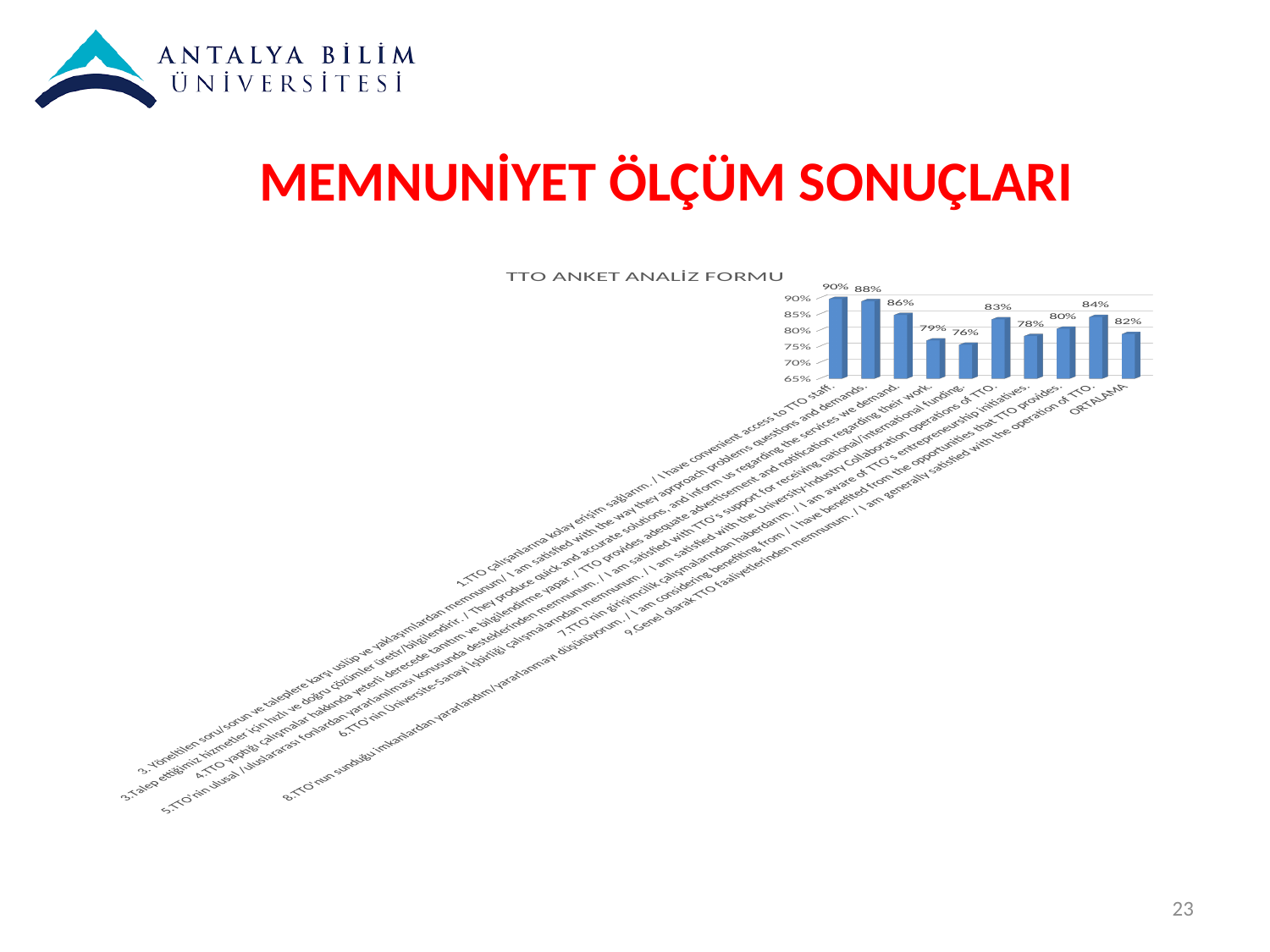
What is the highest value shown in the TTO ANKET ANALİZ FORMU chart? 90% How many bars are plotted in the TTO ANKET ANALİZ FORMU chart? 10 What is the value of the ORTALAMA bar in the TTO ANKET ANALİZ FORMU chart? 82% What is the title of the chart on the slide? TTO ANKET ANALİZ FORMU What is the difference between the highest bar (90%) and the lowest bar (76%) in the chart? 14 percentage points What is the value of the first bar (item 1, 'TTO çalışanlarına kolay erişim sağlarım') in the chart? 90% Which is larger in the chart: the value for item 9 or the ORTALAMA value? Item 9 What type of chart is shown on the slide? Bar chart What is the lowest value shown on the vertical axis of the chart? 65% What is the value of the bar for item 9 ('Genel olarak TTO faaliyetlerinden memnunum') in the chart? 84% What is the lowest value shown in the TTO ANKET ANALİZ FORMU chart? 76%